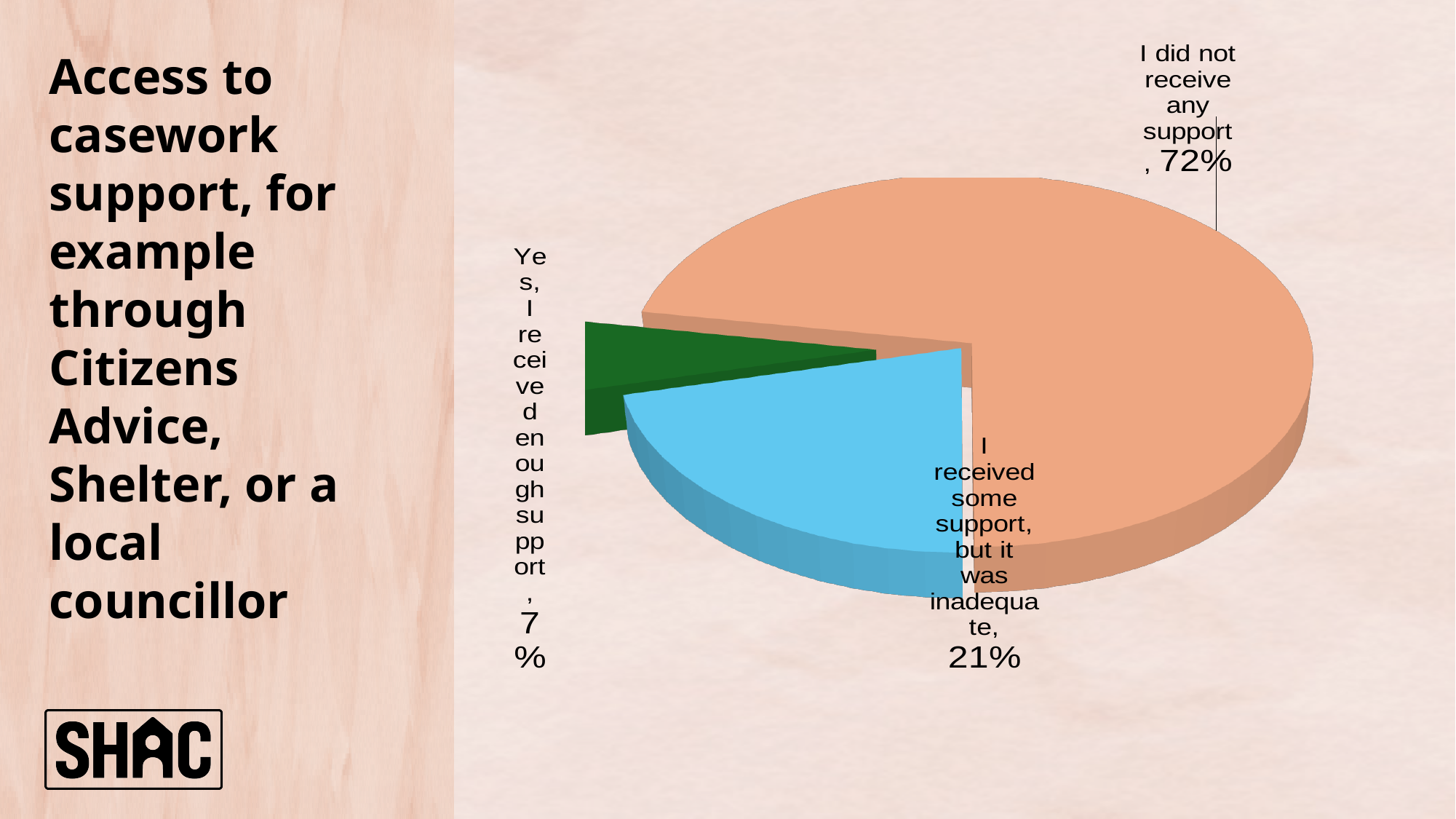
What share of respondents said "I received some support, but it was inadequate"? 21% What is the difference in percentage points between "I received some support, but it was inadequate" and "Yes, I received enough support"? 14 Which response has the smallest slice of the pie? Yes, I received enough support What colour is the slice for "I did not receive any support"? Orange What share of respondents said "I did not receive any support"? 72% What kind of chart is shown on the slide? Pie chart What is the difference in percentage points between "I did not receive any support" and "I received some support, but it was inadequate"? 51 What colour is the slice for "Yes, I received enough support"? Green Which response has the largest slice of the pie? I did not receive any support How many slices does the pie chart have? 3 Which is larger: the share for "I received some support, but it was inadequate" or the share for "Yes, I received enough support"? I received some support, but it was inadequate What share of respondents said "Yes, I received enough support"? 7%